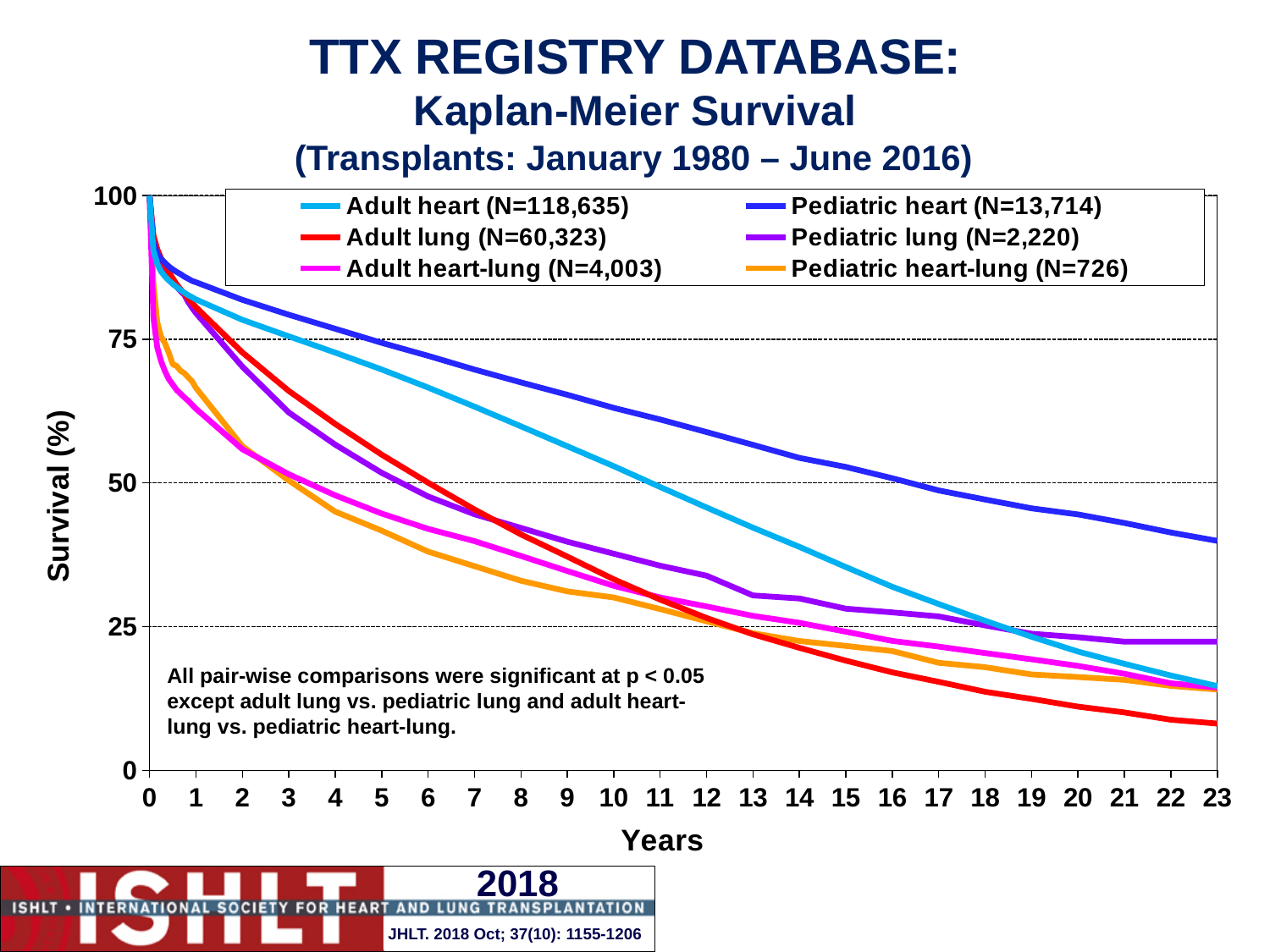
Is the survival for Pediatric heart at year 10 greater or less than 75? less Do the survival curves rise or fall as years increase? fall What kind of chart is shown on the slide? line chart Is the survival for Pediatric heart at year 23 greater or less than 25? greater Is the survival for Adult heart at year 15 greater or less than 50? less How many series does the legend list? 6 At year 10, which has higher survival: Adult heart or Adult lung? Adult heart Which series has the lowest survival at year 23? Adult lung Which series has the highest survival at year 23? Pediatric heart What is the N shown in the legend for Adult heart? 118,635